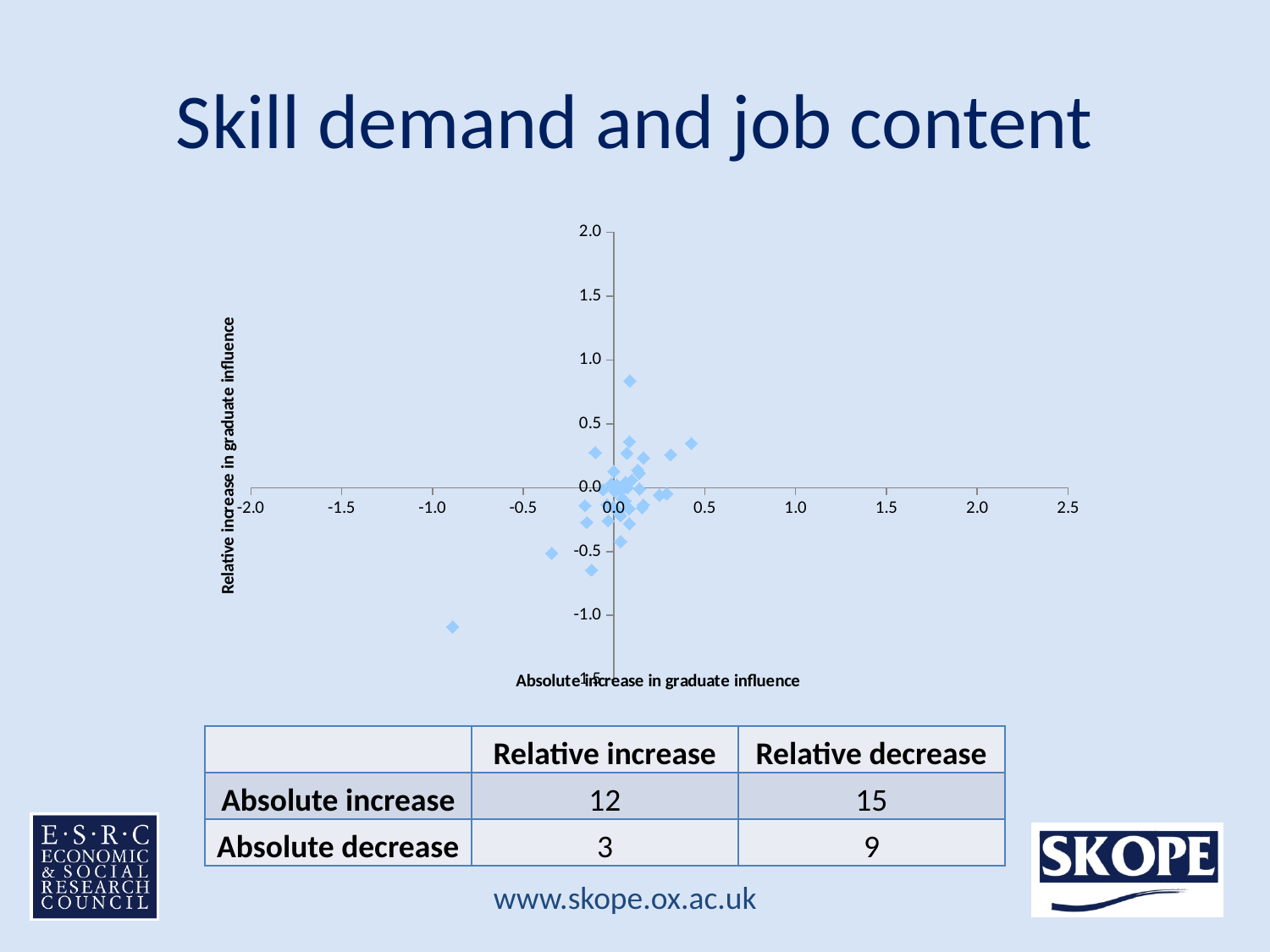
What kind of chart is shown on the slide? Scatter chart Is the horizontal-axis value of the highest point on the chart greater or less than 0.0? greater What is the title of the vertical axis of the chart? Relative increase in graduate influence Is the horizontal-axis value of the rightmost point on the chart greater or less than 0.5? less What is the title of the horizontal axis of the chart? Absolute increase in graduate influence Is the vertical-axis value of the highest point on the chart greater or less than 1.0? less